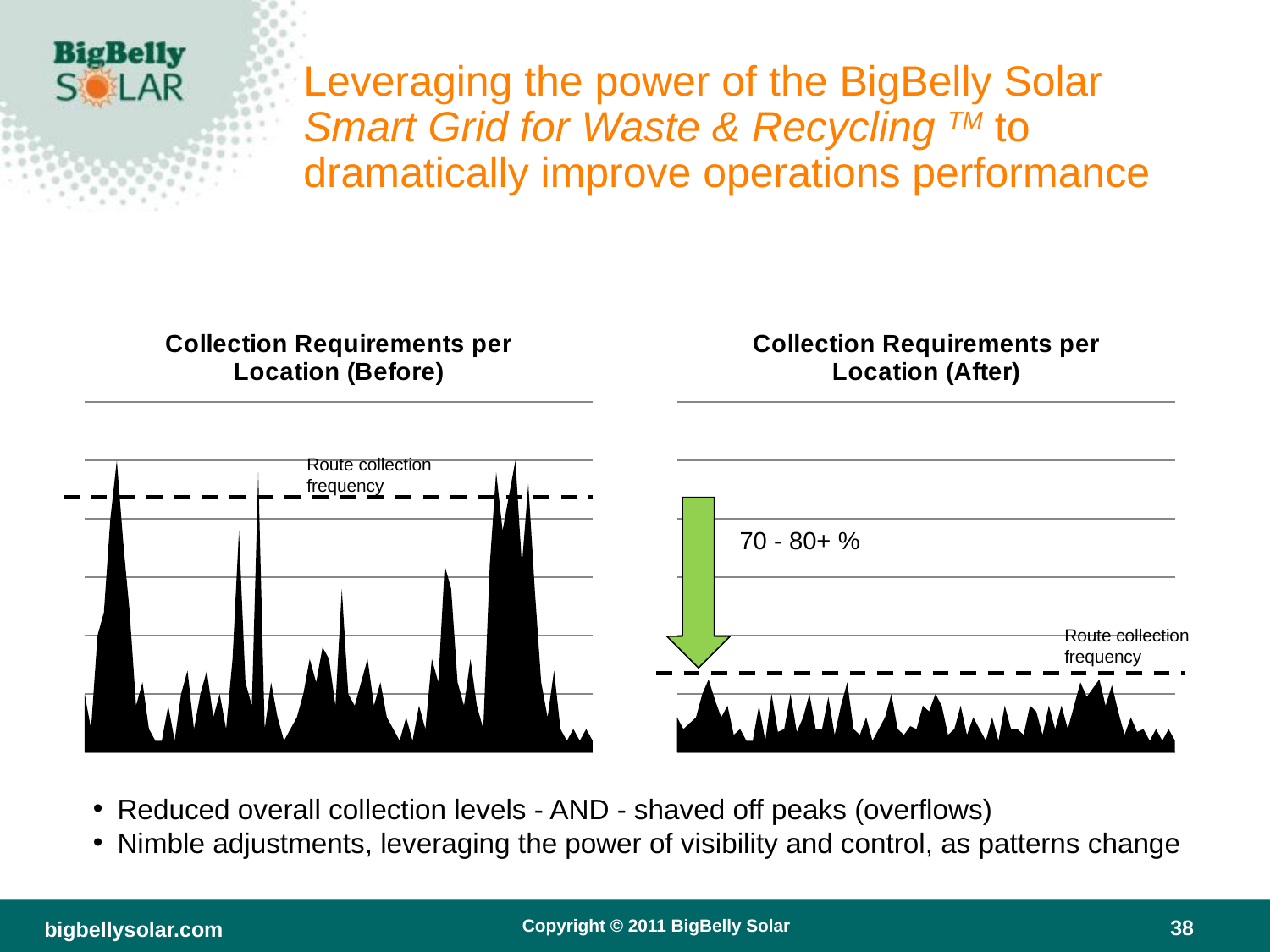
What is the title of the chart on the left side of the slide? Collection Requirements per Location (Before) Which chart has the lower dashed "Route collection frequency" line, the Before chart or the After chart? After In the "Collection Requirements per Location (After)" chart, do the peaks rise above the dashed route collection frequency line? No What is the title of the chart on the right side of the slide? Collection Requirements per Location (After) In the "Collection Requirements per Location (Before)" chart, do the peaks rise above the dashed route collection frequency line? Yes What percentage reduction is annotated on the "Collection Requirements per Location (After)" chart? 70 - 80+ % How many charts are shown on the slide? 2 What kind of chart is the "Collection Requirements per Location (Before)" chart? area chart